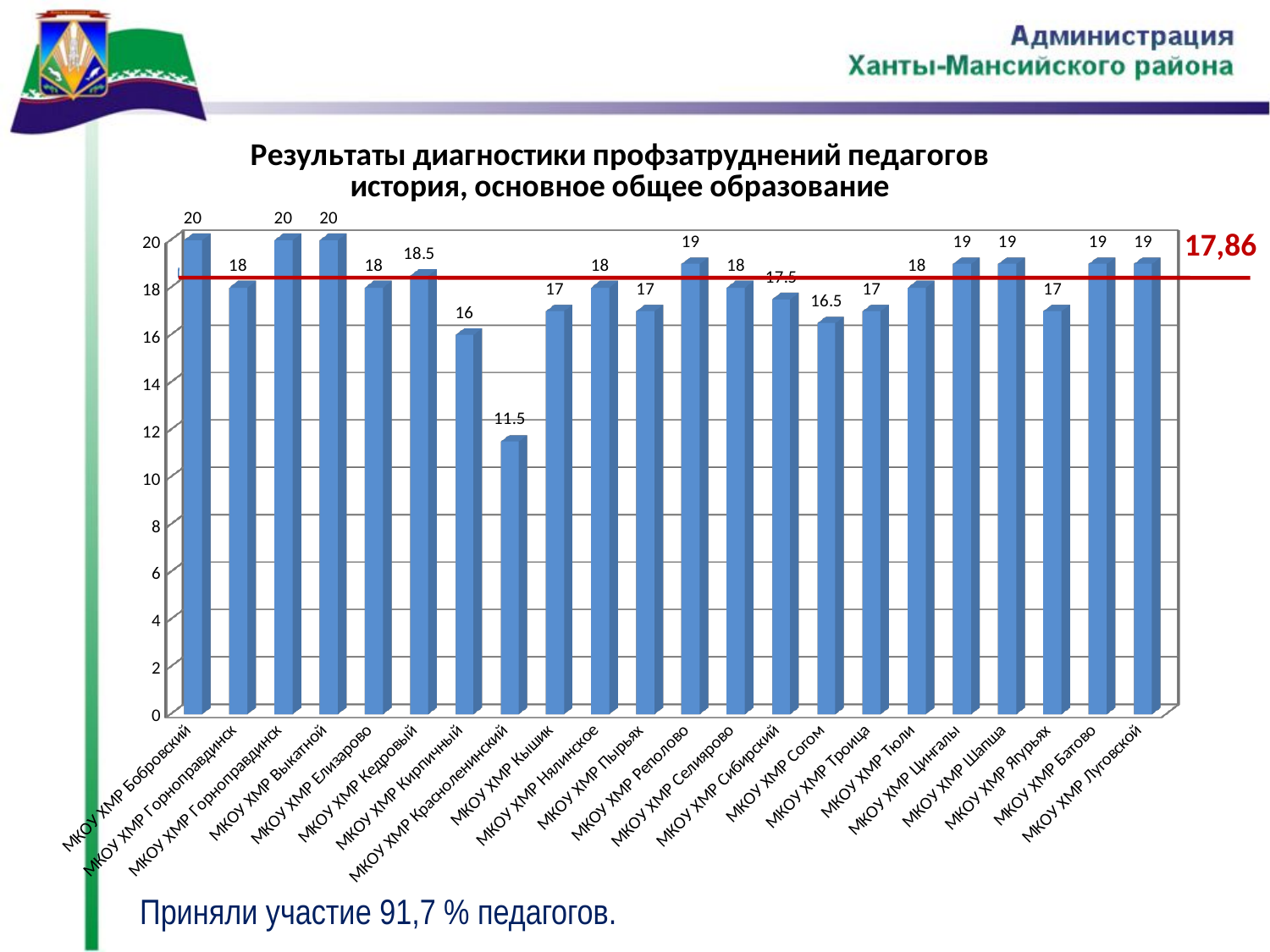
What kind of chart is shown on the slide? Bar chart What is the value for МКОУ ХМР Красноленинский? 11.5 Which category has the lowest value? МКОУ ХМР Красноленинский What is the value for МКОУ ХМР Кедровый? 18.5 What is the value for МКОУ ХМР Шапша? 19 Which has a larger value, МКОУ ХМР Реполово or МКОУ ХМР Сибирский? МКОУ ХМР Реполово What is the value for МКОУ ХМР Согом? 16.5 What is the difference between the values for МКОУ ХМР Кедровый and МКОУ ХМР Красноленинский? 7 What is the difference between the values for МКОУ ХМР Сибирский and МКОУ ХМР Согом? 1 What value is marked by the red horizontal line on the chart? 17,86 What is the highest value shown on the chart? 20 How many categories are shown on the x axis? 22